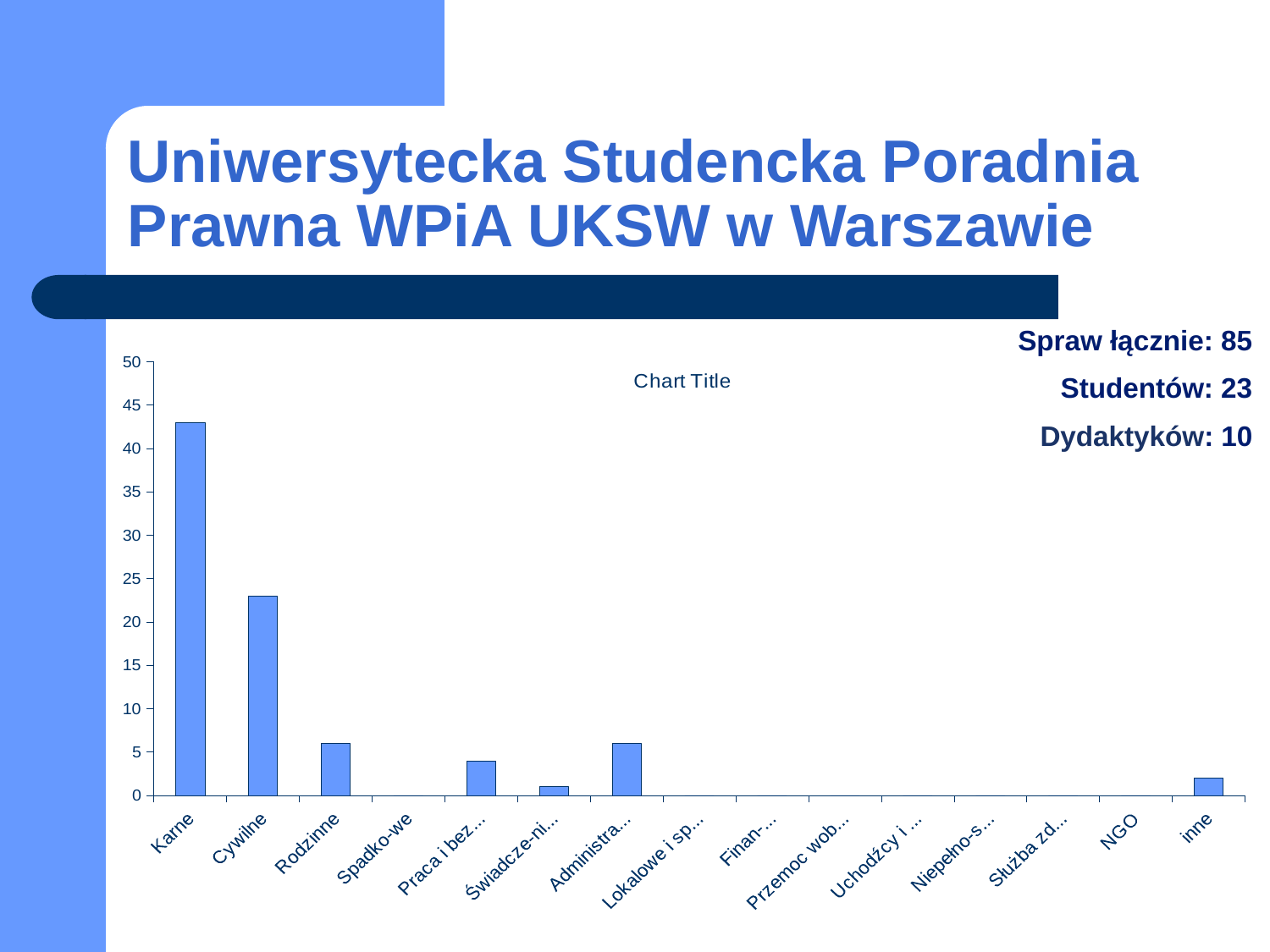
Is the value for inne greater or less than 5? less Which category has the highest value in the chart? Karne Which is larger, the value for Karne or the value for Cywilne? Karne What kind of chart is shown on the slide? bar chart Which is larger, the value for Praca i bez... or the value for Świadcze-ni...? Praca i bez... How many categories are shown on the x axis of the chart? 15 Is the value for Administra... greater or less than 10? less Is the value for Cywilne greater or less than 20? greater What is the title shown on the chart? Chart Title